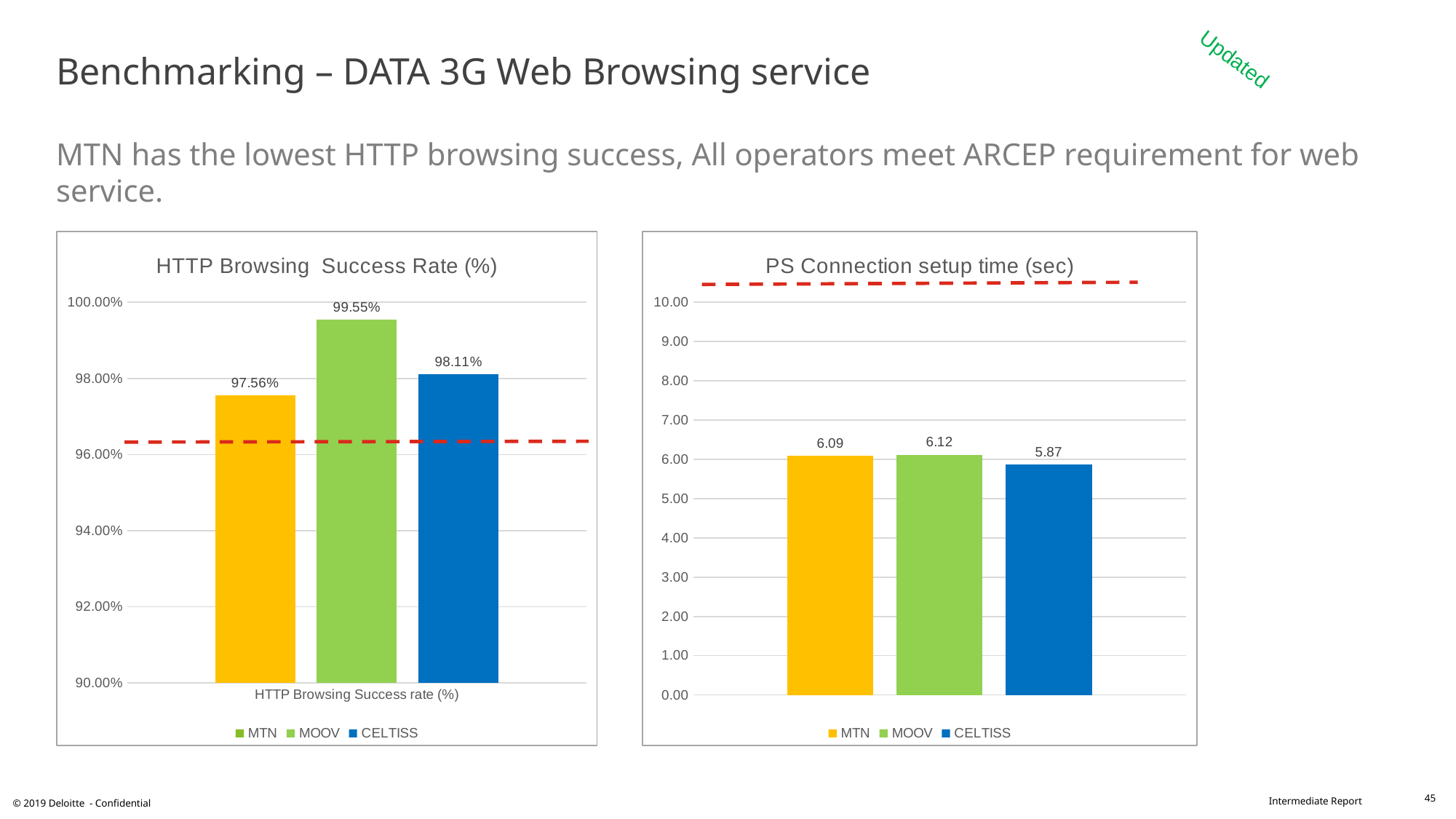
What kind of chart is the HTTP Browsing Success Rate (%) chart? Bar chart In the PS Connection setup time (sec) chart, is the value for MTN greater or less than 7.00? less In the HTTP Browsing Success Rate (%) chart, what is the value for MOOV? 99.55% In the HTTP Browsing Success Rate (%) chart, what is the difference between the MOOV and CELTISS values? 1.44% In the PS Connection setup time (sec) chart, what is the value for MTN? 6.09 In the HTTP Browsing Success Rate (%) chart, which operator has the highest success rate? MOOV In the HTTP Browsing Success Rate (%) chart, which operator has the lowest success rate? MTN How many series does the legend of the PS Connection setup time (sec) chart list? 3 In the PS Connection setup time (sec) chart, what is the difference between the MOOV and CELTISS values? 0.25 In the HTTP Browsing Success Rate (%) chart, what is the value for MTN? 97.56% In the PS Connection setup time (sec) chart, what is the value for CELTISS? 5.87 In the PS Connection setup time (sec) chart, which operator has the lowest setup time? CELTISS